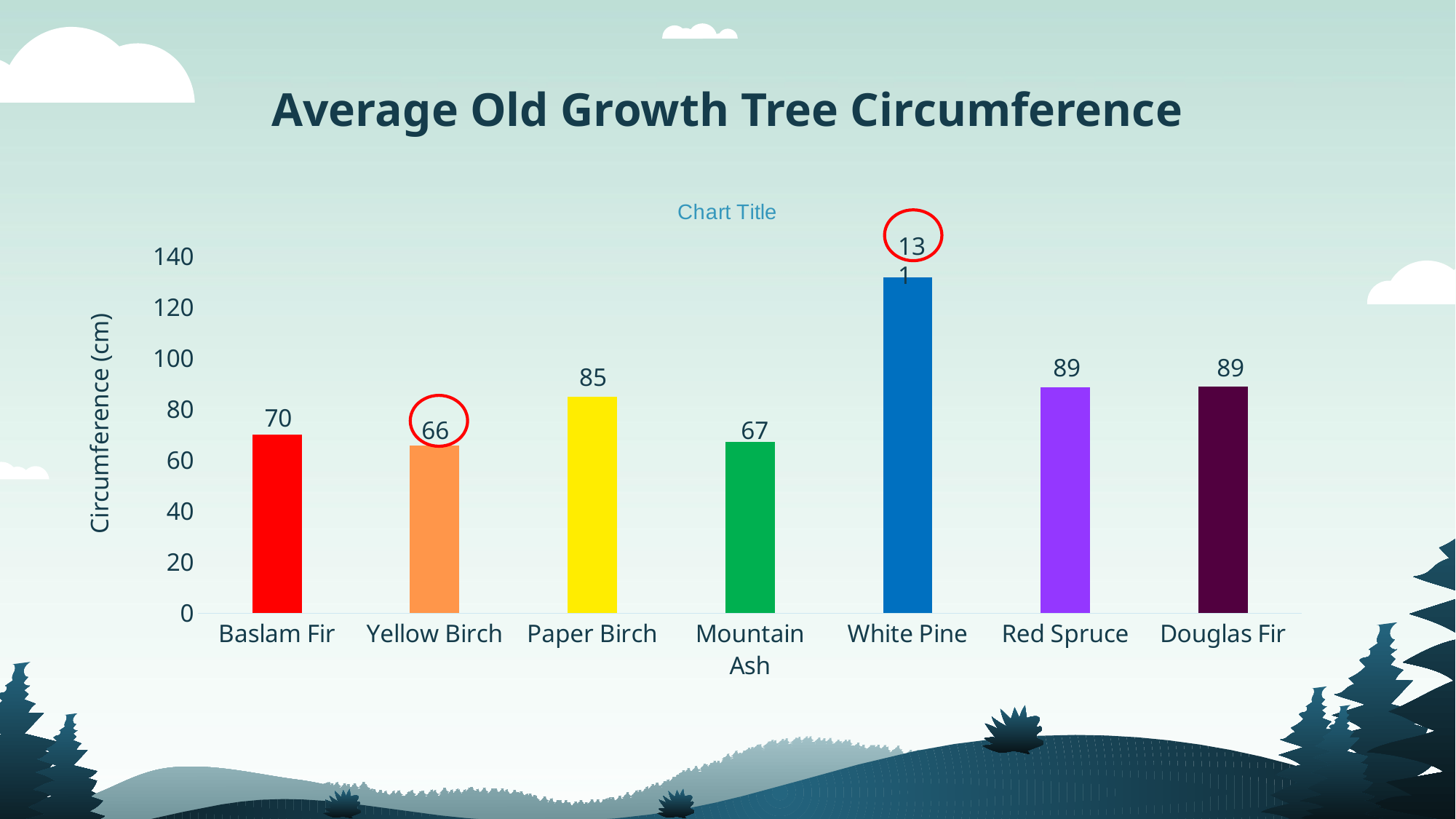
What is the average circumference for Baslam Fir? 70 What is the difference between the values for Red Spruce and Yellow Birch? 23 What kind of chart is shown on the slide? bar chart Is the value for White Pine greater or less than 120? greater What is the value shown for Paper Birch? 85 Which tree has the highest average circumference? White Pine Which is larger, the value for Paper Birch or the value for Mountain Ash? Paper Birch What is the difference between the values for Paper Birch and Baslam Fir? 15 What is the value shown for Mountain Ash? 67 How many tree species are shown on the chart? 7 What is the value shown for White Pine? 131 Which tree has the lowest average circumference? Yellow Birch